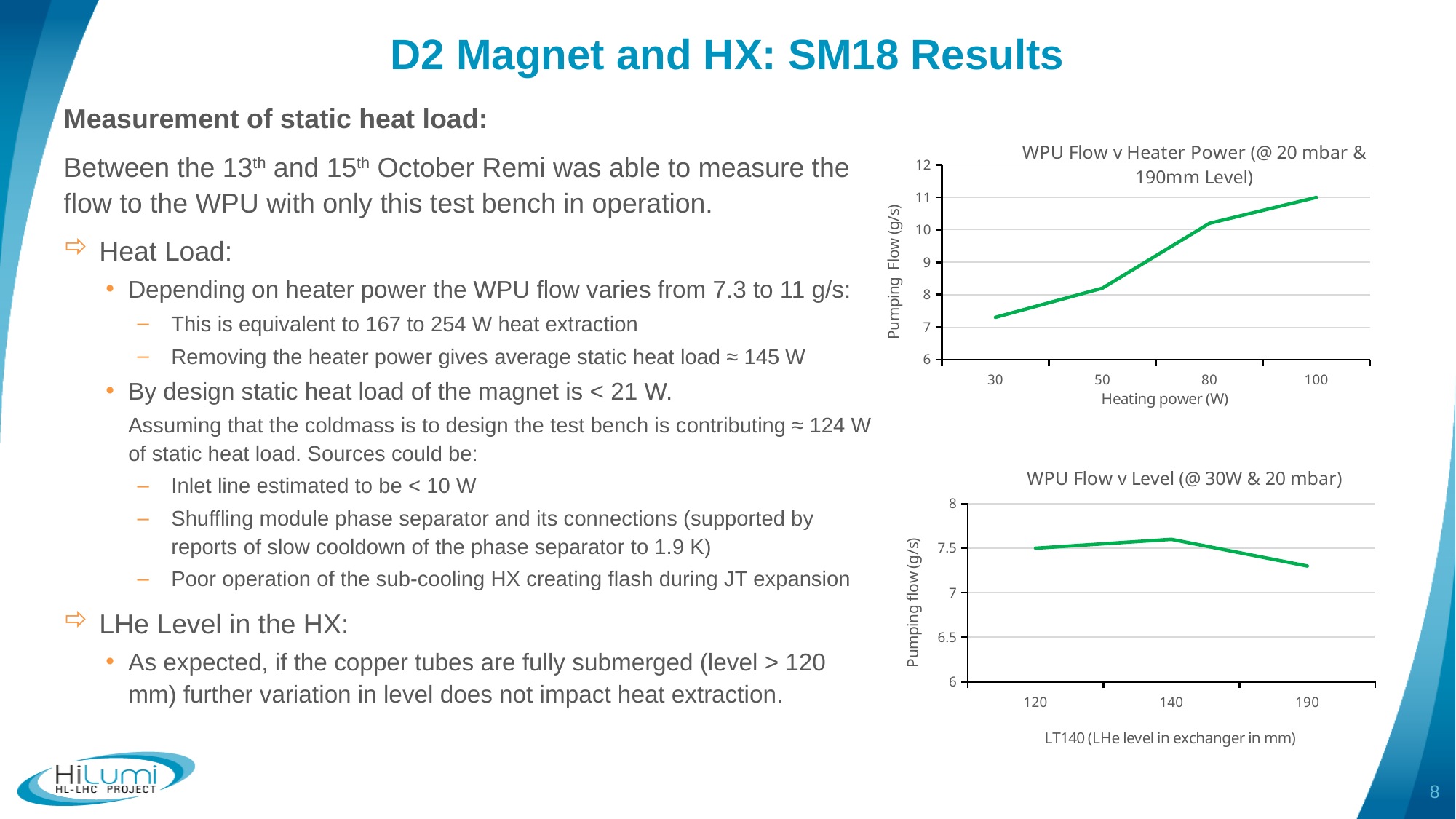
In the top chart, 'WPU Flow v Heater Power', is the pumping flow at 80 W greater or less than 9? greater How many heating power points are plotted in the top chart, 'WPU Flow v Heater Power'? 4 What kind of chart is the top chart, 'WPU Flow v Heater Power (@ 20 mbar & 190mm Level)'? line chart In the top chart, 'WPU Flow v Heater Power', does the pumping flow rise or fall as heating power increases from 30 W to 100 W? rise In the top chart, 'WPU Flow v Heater Power', which heating power gives the lowest pumping flow? 30 What kind of chart is the bottom chart, 'WPU Flow v Level (@ 30W & 20 mbar)'? line chart In the top chart, 'WPU Flow v Heater Power', which heating power gives the highest pumping flow? 100 What is the x-axis label of the top chart, 'WPU Flow v Heater Power'? Heating power (W) In the bottom chart, 'WPU Flow v Level', which level has the lowest pumping flow? 190 How many level points are plotted in the bottom chart, 'WPU Flow v Level'? 3 In the top chart, 'WPU Flow v Heater Power', is the pumping flow at 30 W greater or less than 8? less In the bottom chart, 'WPU Flow v Level', is the pumping flow at 190 mm greater or less than 7? greater